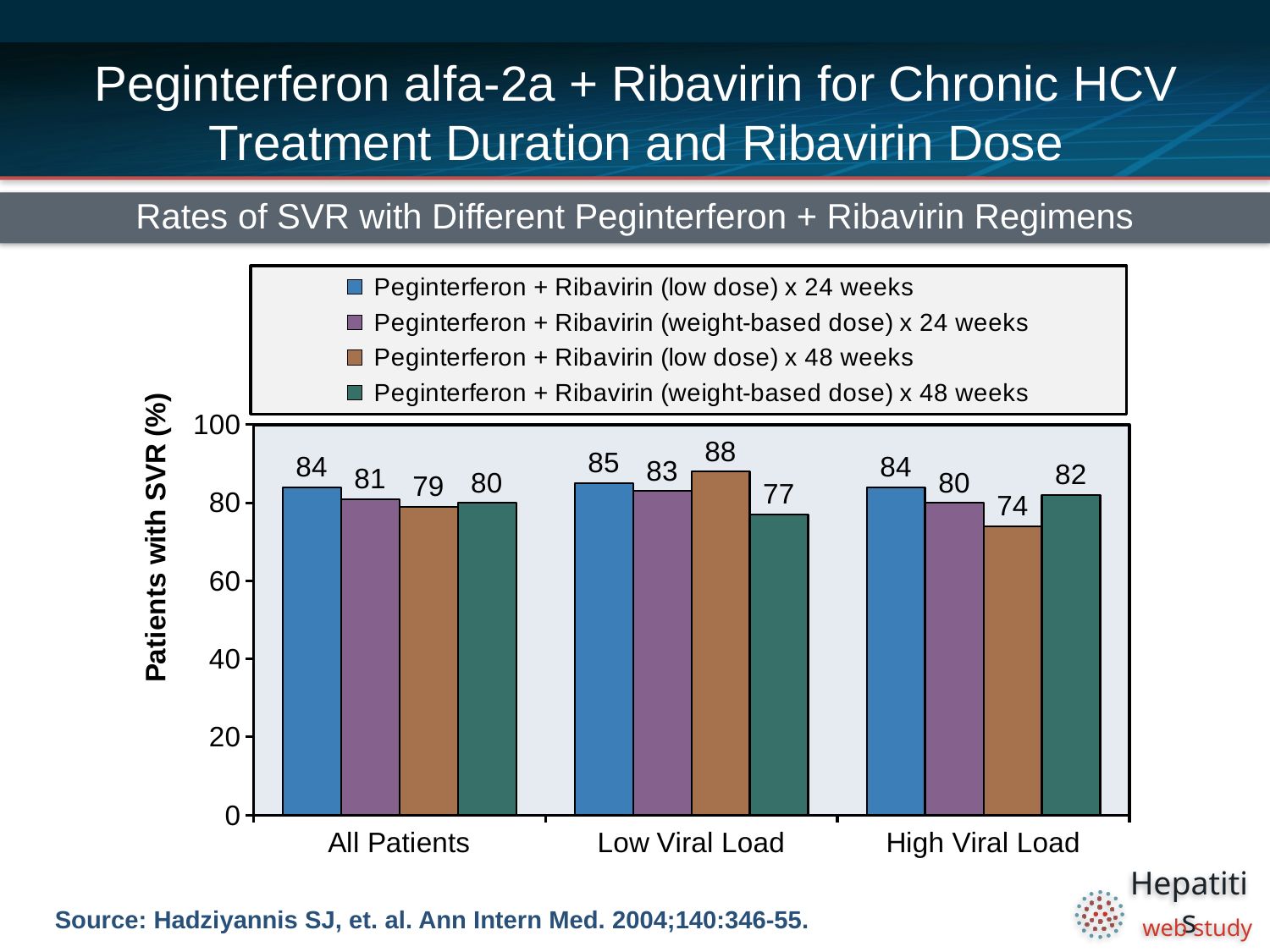
What is the SVR rate for Peginterferon + Ribavirin (low dose) x 24 weeks in All Patients? 84 How many series does the legend list? 4 What is the difference in SVR rate between the low dose x 48 weeks and weight-based dose x 48 weeks regimens in the Low Viral Load group? 11 How many patient groups are shown on the x axis? 3 In the High Viral Load group, which has a higher SVR rate: low dose x 24 weeks or low dose x 48 weeks? Low dose x 24 weeks What kind of chart is shown on the slide? Bar chart What is the SVR rate for Peginterferon + Ribavirin (weight-based dose) x 48 weeks in the High Viral Load group? 82 Which regimen has the highest SVR rate in the Low Viral Load group? Peginterferon + Ribavirin (low dose) x 48 weeks Which regimen has the lowest SVR rate in the High Viral Load group? Peginterferon + Ribavirin (low dose) x 48 weeks What is the label of the y axis? Patients with SVR (%) What is the difference in SVR rate between the low dose x 24 weeks and low dose x 48 weeks regimens in All Patients? 5 What is the SVR rate for Peginterferon + Ribavirin (low dose) x 48 weeks in the Low Viral Load group? 88